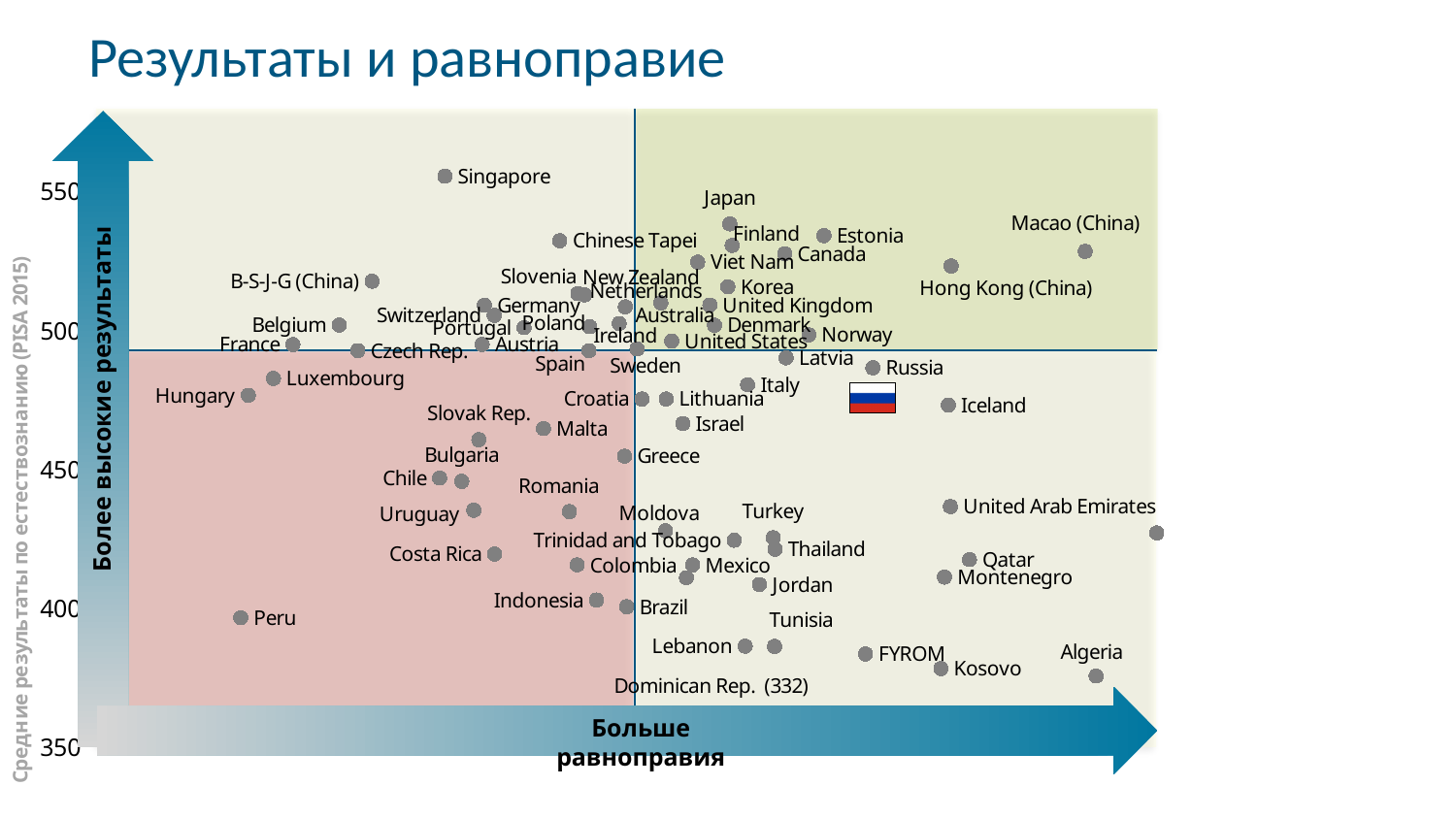
Is the value for Algeria greater or less than 400? less Which country has the highest value on the vertical axis? Singapore What kind of chart is shown on the slide? scatter plot What is the value printed for Dominican Rep.? 332 Is the value for Peru greater or less than 450? less Is the value for Singapore greater or less than 550? greater Which country has the lowest value on the vertical axis? Dominican Rep. What is the title of the slide? Результаты и равноправие Which has a higher value on the vertical axis, Peru or Singapore? Singapore Which has a higher value on the vertical axis, Japan or Brazil? Japan